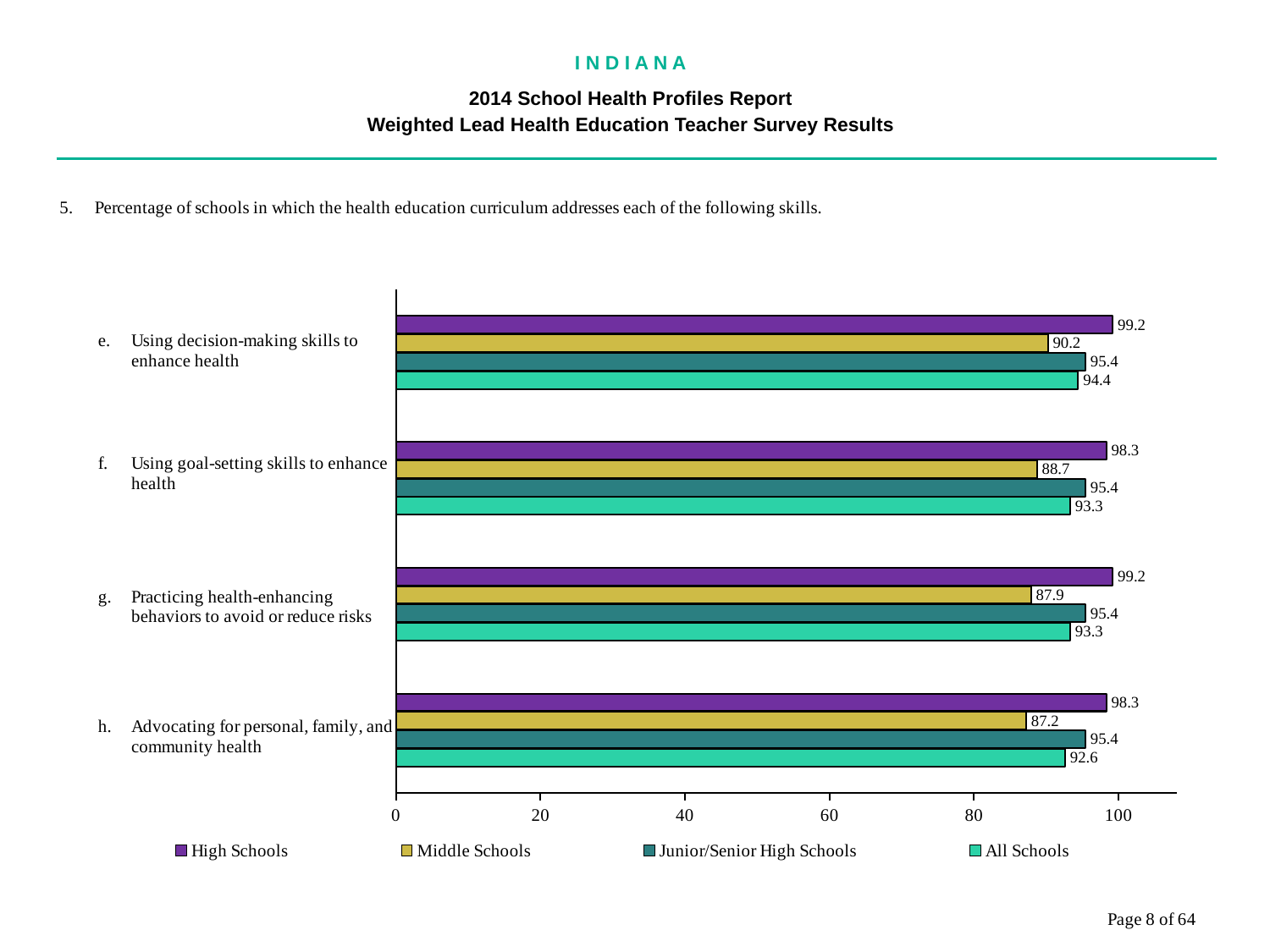
What is the difference between the High Schools and Middle Schools values for 'Using decision-making skills to enhance health'? 9.0 Which series has the highest value for 'Advocating for personal, family, and community health'? High Schools What kind of chart is shown on the slide? Bar chart How many skill categories are shown on the chart? 4 Which series has the lowest value for 'Using goal-setting skills to enhance health'? Middle Schools What is the value for Junior/Senior High Schools for 'Practicing health-enhancing behaviors to avoid or reduce risks'? 95.4 What is the value for All Schools for 'Using goal-setting skills to enhance health'? 93.3 Which category has the lowest Middle Schools value? Advocating for personal, family, and community health Which is larger for 'Practicing health-enhancing behaviors to avoid or reduce risks': the Middle Schools value or the All Schools value? All Schools What is the value for High Schools for 'Using decision-making skills to enhance health'? 99.2 What is the value for Middle Schools for 'Advocating for personal, family, and community health'? 87.2 How many series does the legend list? 4